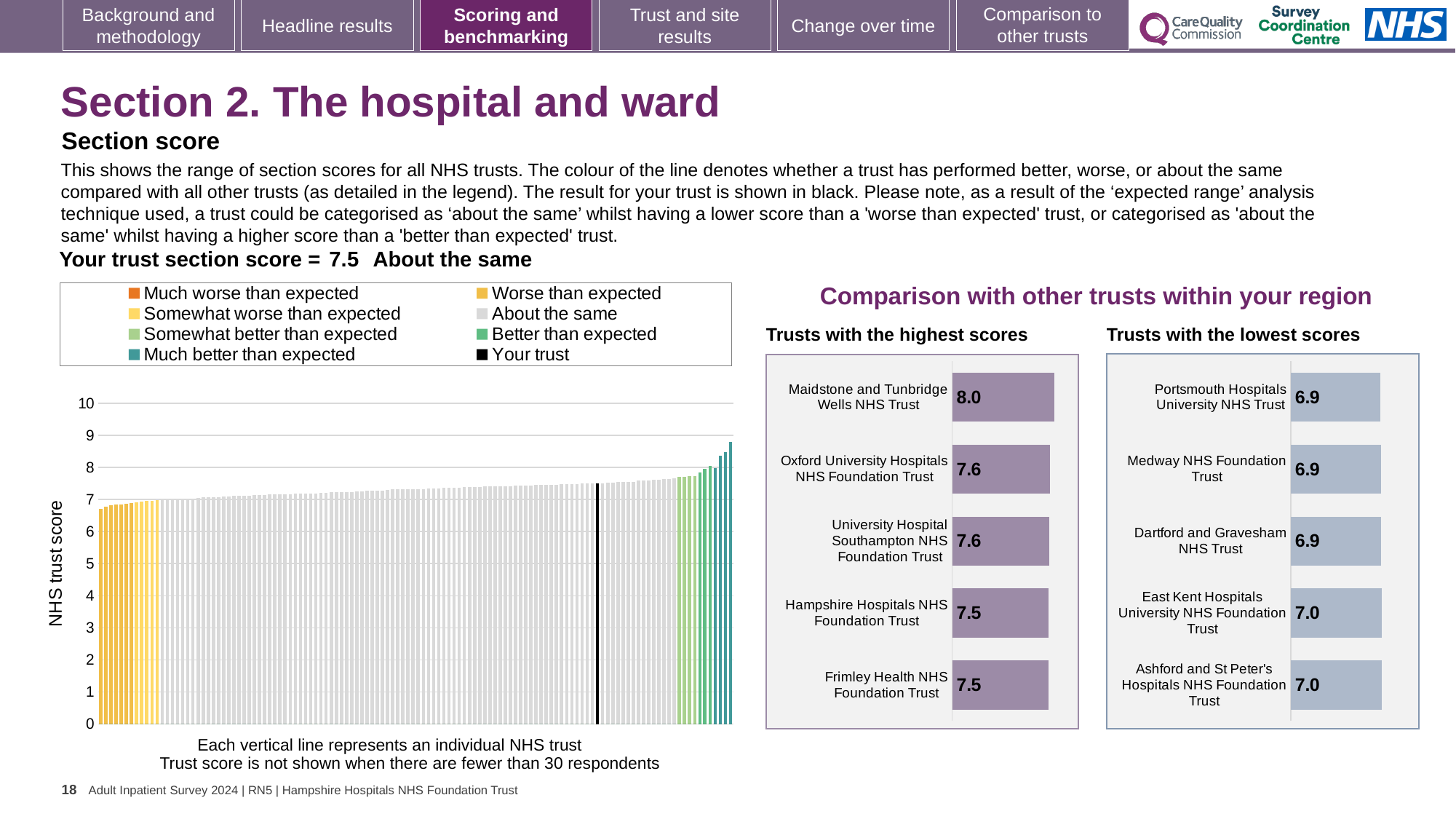
How many entries does the legend of the large chart on the left list? 8 In the large chart on the left, is the value of the tallest bar greater or less than 8? greater In the 'Trusts with the highest scores' chart, what is the difference between the scores of Maidstone and Tunbridge Wells NHS Trust and Frimley Health NHS Foundation Trust? 0.5 In the large chart on the left, what is the section score for your trust (the black bar)? 7.5 In the 'Trusts with the highest scores' chart, which has the larger score: Maidstone and Tunbridge Wells NHS Trust or Hampshire Hospitals NHS Foundation Trust? Maidstone and Tunbridge Wells NHS Trust In the 'Trusts with the highest scores' chart, what is the score for Maidstone and Tunbridge Wells NHS Trust? 8.0 In the large chart on the left, do the bar values rise or fall from left to right? rise In the 'Trusts with the lowest scores' chart, what is the score for Dartford and Gravesham NHS Trust? 6.9 What kind of chart is the large chart on the left showing NHS trust scores? bar chart In the 'Trusts with the lowest scores' chart, what is the difference between the scores of East Kent Hospitals University NHS Foundation Trust and Portsmouth Hospitals University NHS Trust? 0.1 In the 'Trusts with the highest scores' chart, which trust has the highest score? Maidstone and Tunbridge Wells NHS Trust How many trusts are shown in the 'Trusts with the highest scores' chart? 5